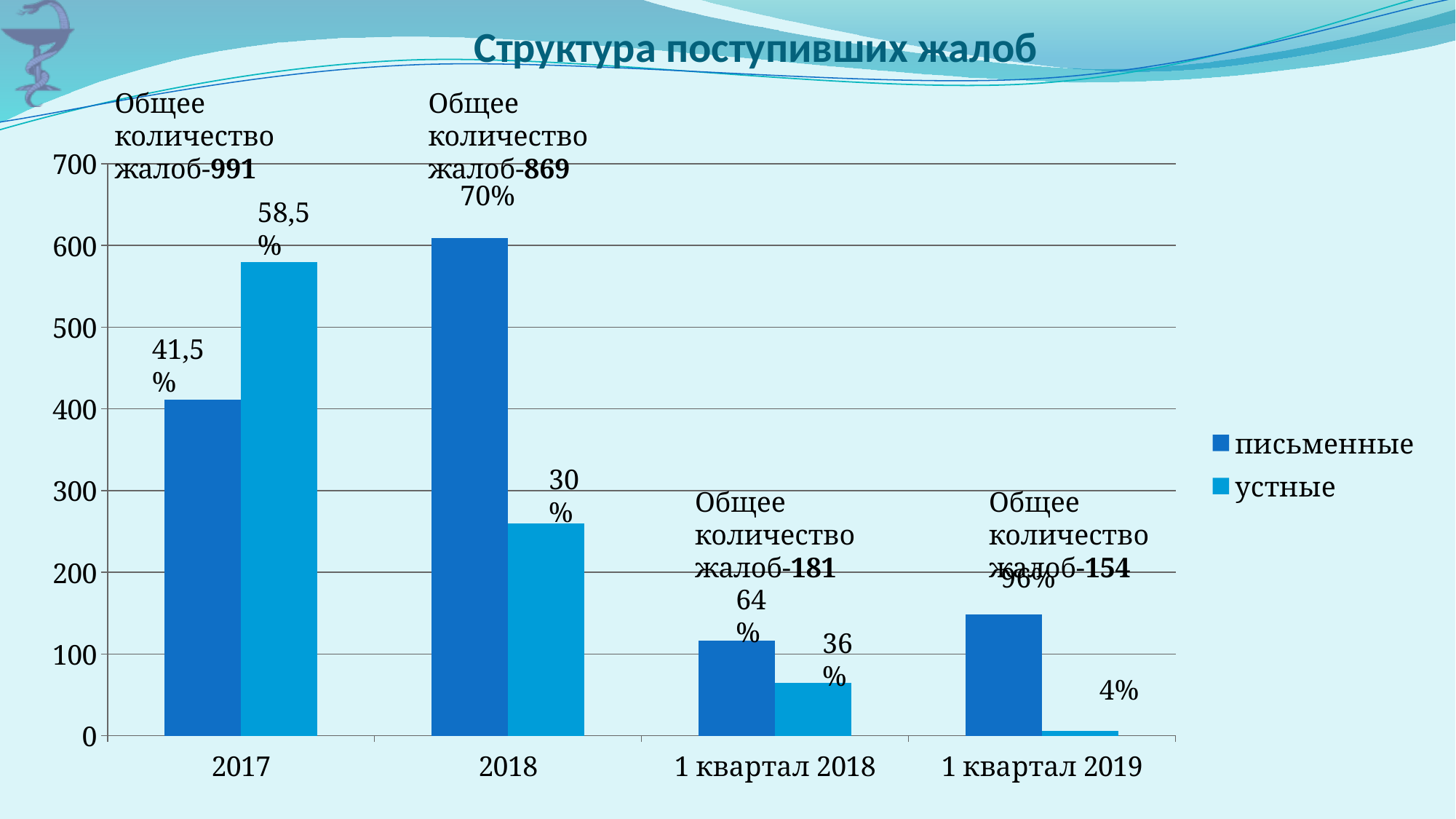
What type of chart is shown on the slide? bar chart Is the value for письменные in 2018 greater or less than 600? greater How many categories are shown on the x axis? 4 What percentage label is shown for письменные in 2017? 41,5% What percentage label is shown for устные in 2018? 30% Which category has the shortest устные bar? 1 квартал 2019 What is the total number of complaints (Общее количество жалоб) stated for 2018? 869 In 2017, which series has the larger bar, письменные or устные? устные What is the total number of complaints (Общее количество жалоб) stated for 1 квартал 2018? 181 How many series does the legend list? 2 What percentage label is shown for устные in 1 квартал 2019? 4% Which category has the tallest письменные bar? 2018